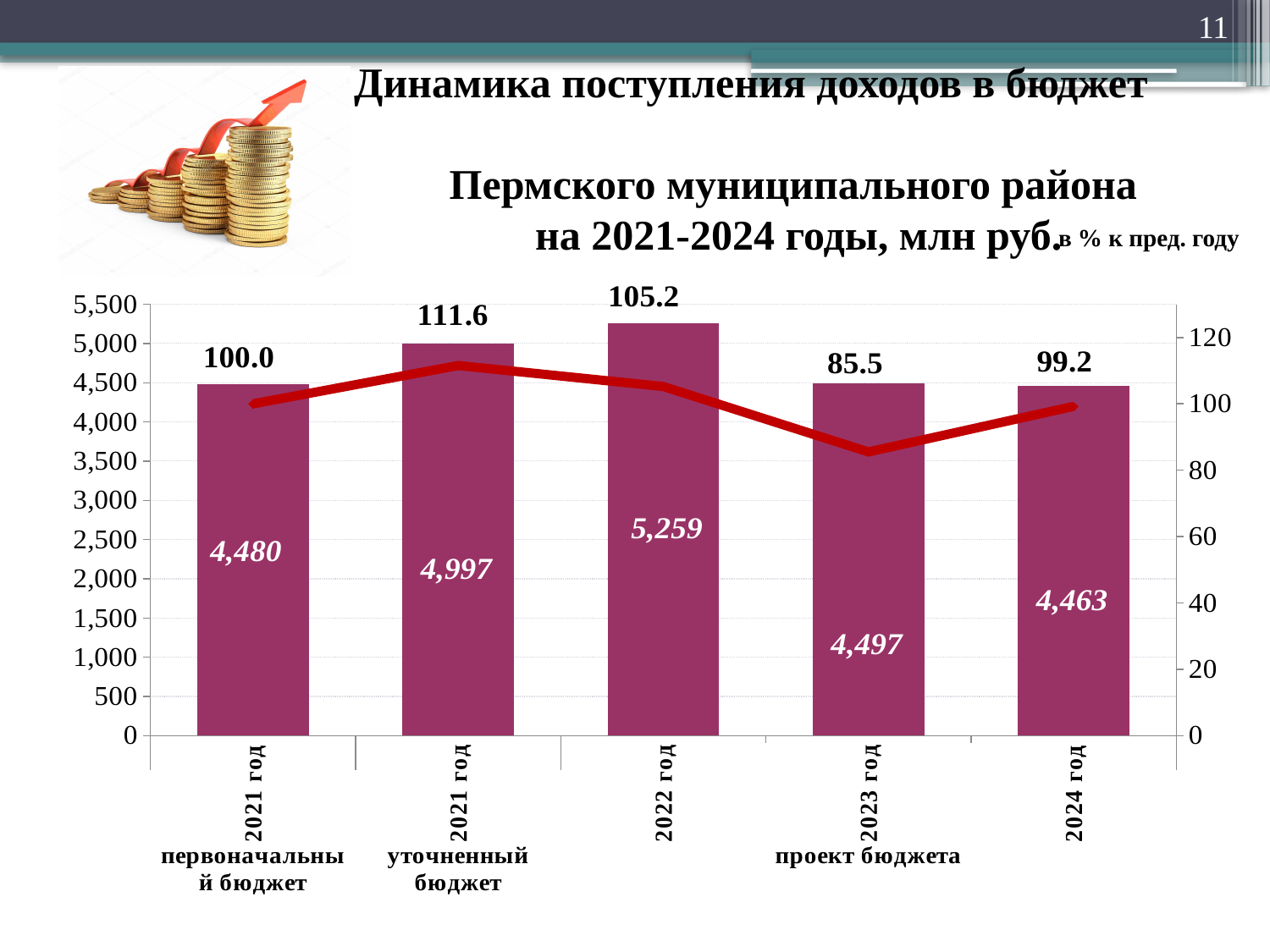
Which year has the highest bar value? 2022 год How many bars are plotted on the chart? 5 What is the budget revenue value shown for 2022 год? 5,259 What is the bar value for 2021 год (уточненный бюджет)? 4,997 What is the difference between the bar values for 2022 год and 2024 год? 796 Does the line value fall or rise from 2022 год to 2023 год? fall Which is larger, the bar value for 2021 год (первоначальный бюджет) or for 2023 год? 2023 год What percentage to the previous year is shown for 2023 год? 85.5 What percentage to the previous year is shown for 2021 год (уточненный бюджет)? 111.6 Which category has the lowest percentage to the previous year on the line? 2023 год What unit is stated in the chart title for the bar values? млн руб. What is the difference between the line values for 2021 год (уточненный бюджет) and 2022 год? 6.4